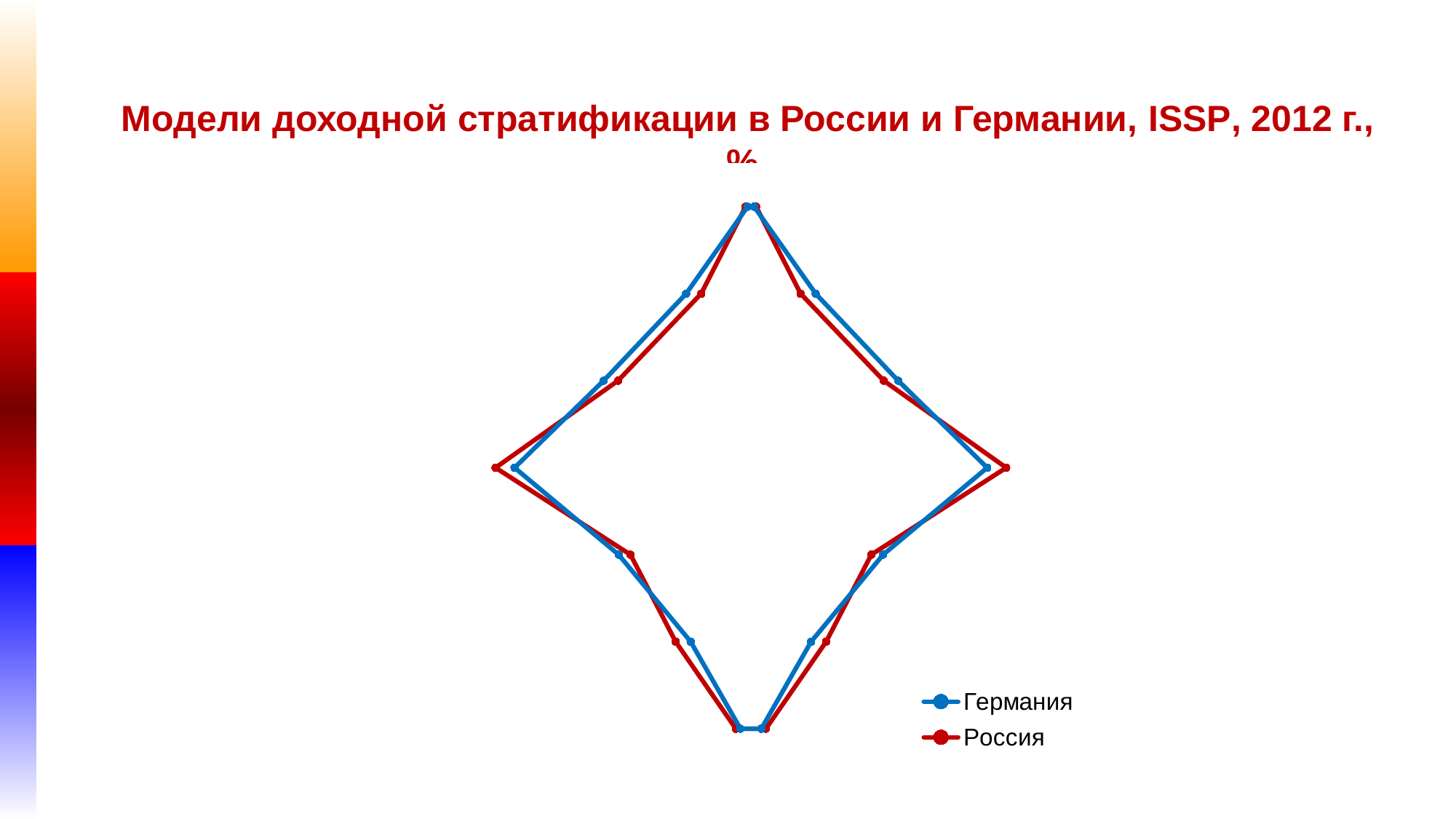
On the axis pointing to the far right of the chart, which series extends further out, Германия or Россия? Россия How many series does the legend list? 2 What kind of chart is shown on the slide? Scatter chart with lines (line chart) On the axis pointing to the far left of the chart, which series extends further out, Германия or Россия? Россия What are the two series named in the legend? Германия and Россия Which colour is used for the Россия series? Red